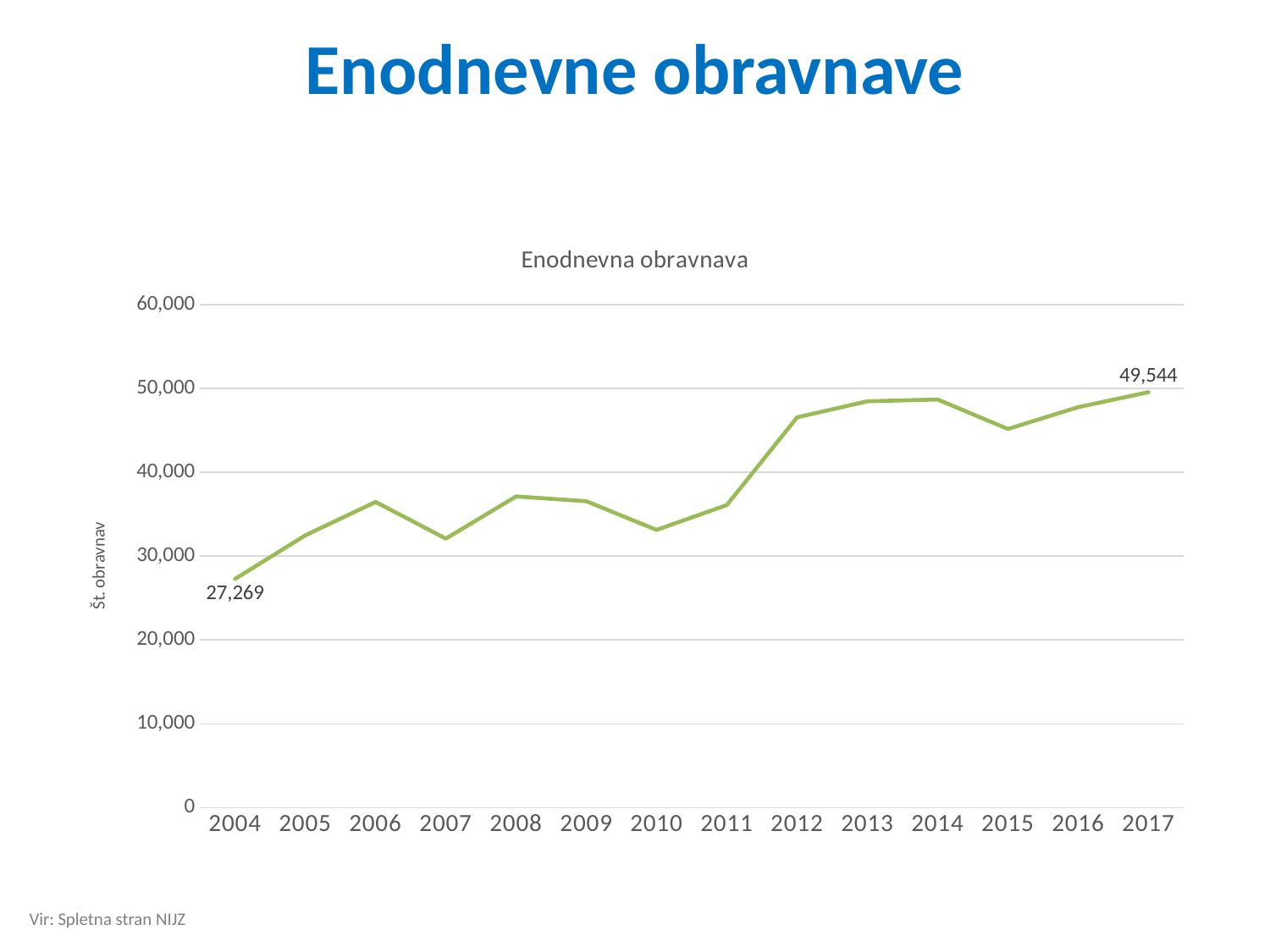
What is the title of the chart? Enodnevna obravnava How many years are shown on the x axis? 14 What is the value for 2017? 49,544 Is the value for 2007 greater or less than 40,000? less What is the difference between the values for 2017 and 2004? 22,275 What kind of chart is shown? line chart What is the value for 2004? 27,269 Is the value for 2010 greater or less than 30,000? greater Which is larger, the value for 2006 or the value for 2007? 2006 Is the value for 2012 greater or less than 40,000? greater Which is larger, the value for 2014 or the value for 2015? 2014 Which year has the lowest value? 2004